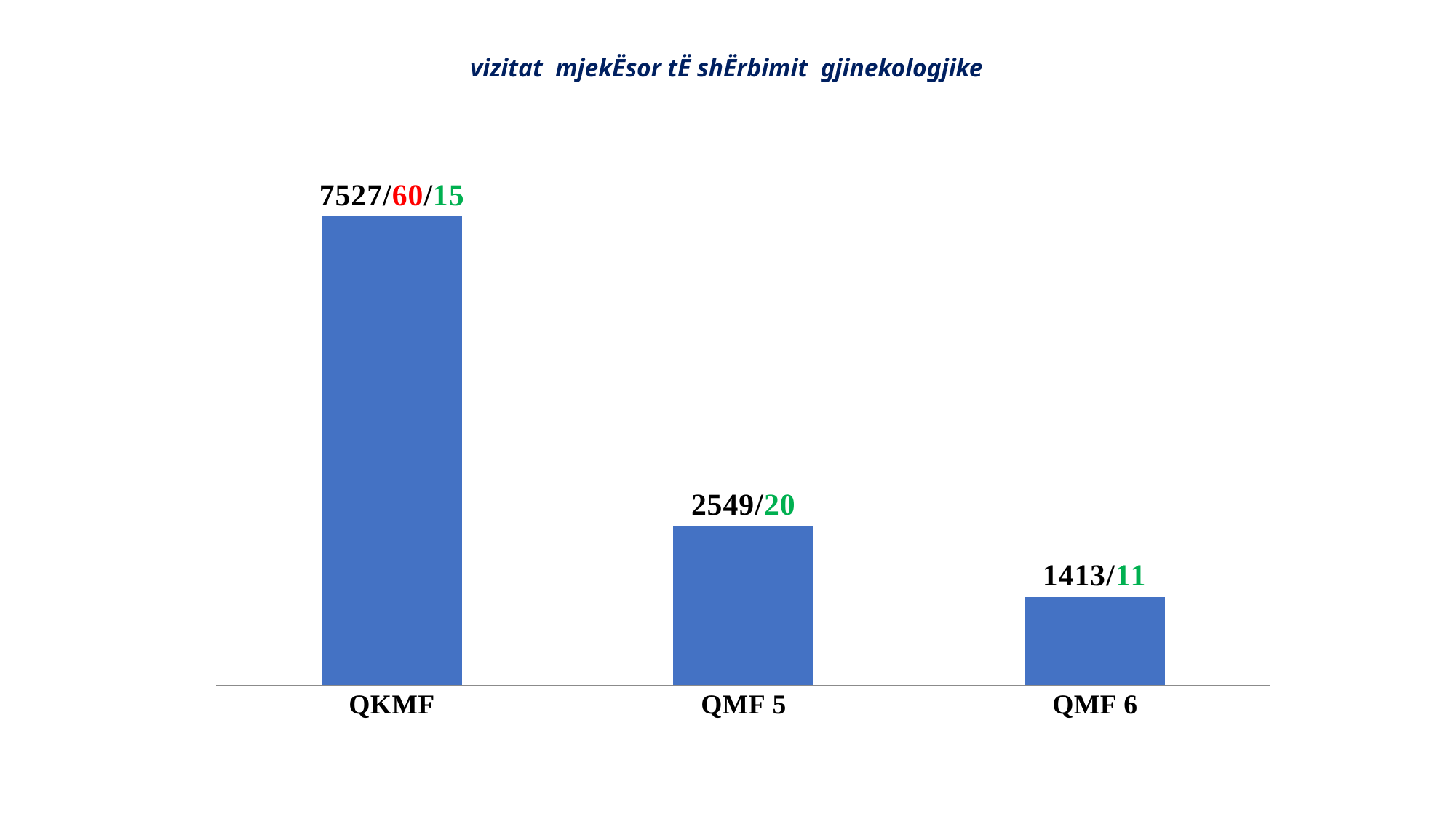
What is the data label shown above the QMF 5 bar? 2549/20 What is the first number in the data label for QKMF? 7527 What is the title of the chart? vizitat mjekËsor tË shËrbimit gjinekologjike How many categories are shown on the x axis? 3 Which bar is taller, QMF 5 or QMF 6? QMF 5 What is the data label shown above the QMF 6 bar? 1413/11 What is the data label shown above the QKMF bar? 7527/60/15 Which category has the tallest bar? QKMF What kind of chart is shown on the slide? Bar chart What is the difference between the first number in the QKMF label (7527) and the first number in the QMF 5 label (2549)? 4978 Do the bar heights rise or fall from left to right across the x axis? Fall Which category has the shortest bar? QMF 6